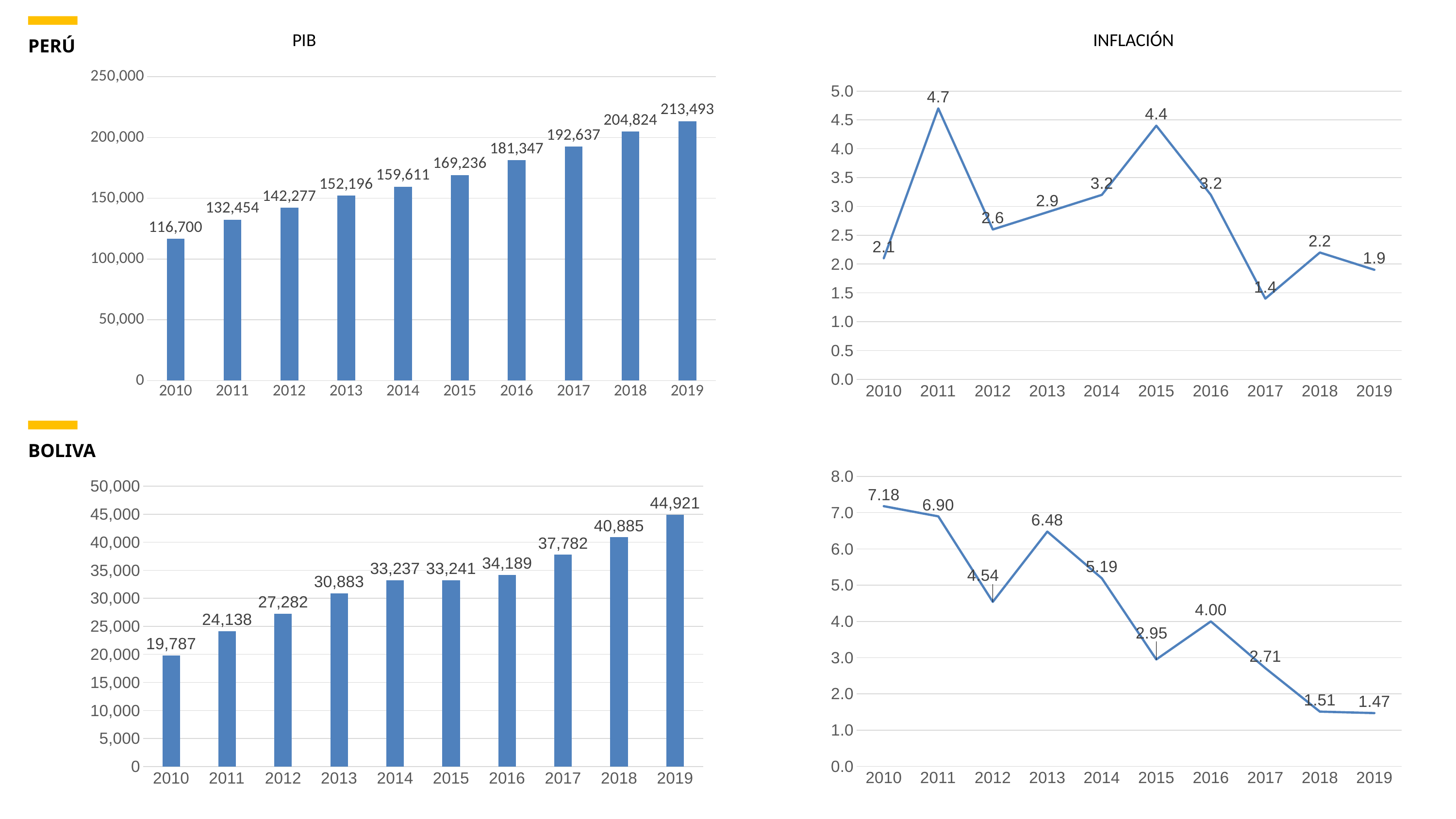
In the Perú PIB bar chart, what is the value for 2015? 169,236 In the Perú INFLACIÓN line chart, what is the value for 2011? 4.7 In the Bolivia INFLACIÓN line chart, which is larger, the value for 2013 or the value for 2014? 2013 In the Perú INFLACIÓN line chart, is the value for 2015 greater or less than 4.0? greater What kind of chart is the Perú PIB chart? bar chart In the Bolivia PIB bar chart, how many years are shown on the x axis? 10 In the Perú INFLACIÓN line chart, which year has the lowest value? 2017 In the Bolivia INFLACIÓN line chart, what is the value for 2012? 4.54 In the Perú PIB bar chart, which year has the highest value? 2019 In the Bolivia PIB bar chart, do the values generally rise or fall from 2010 to 2019? rise In the Perú PIB bar chart, what is the difference between the 2019 and 2010 values? 96,793 In the Bolivia PIB bar chart, what is the value for 2013? 30,883